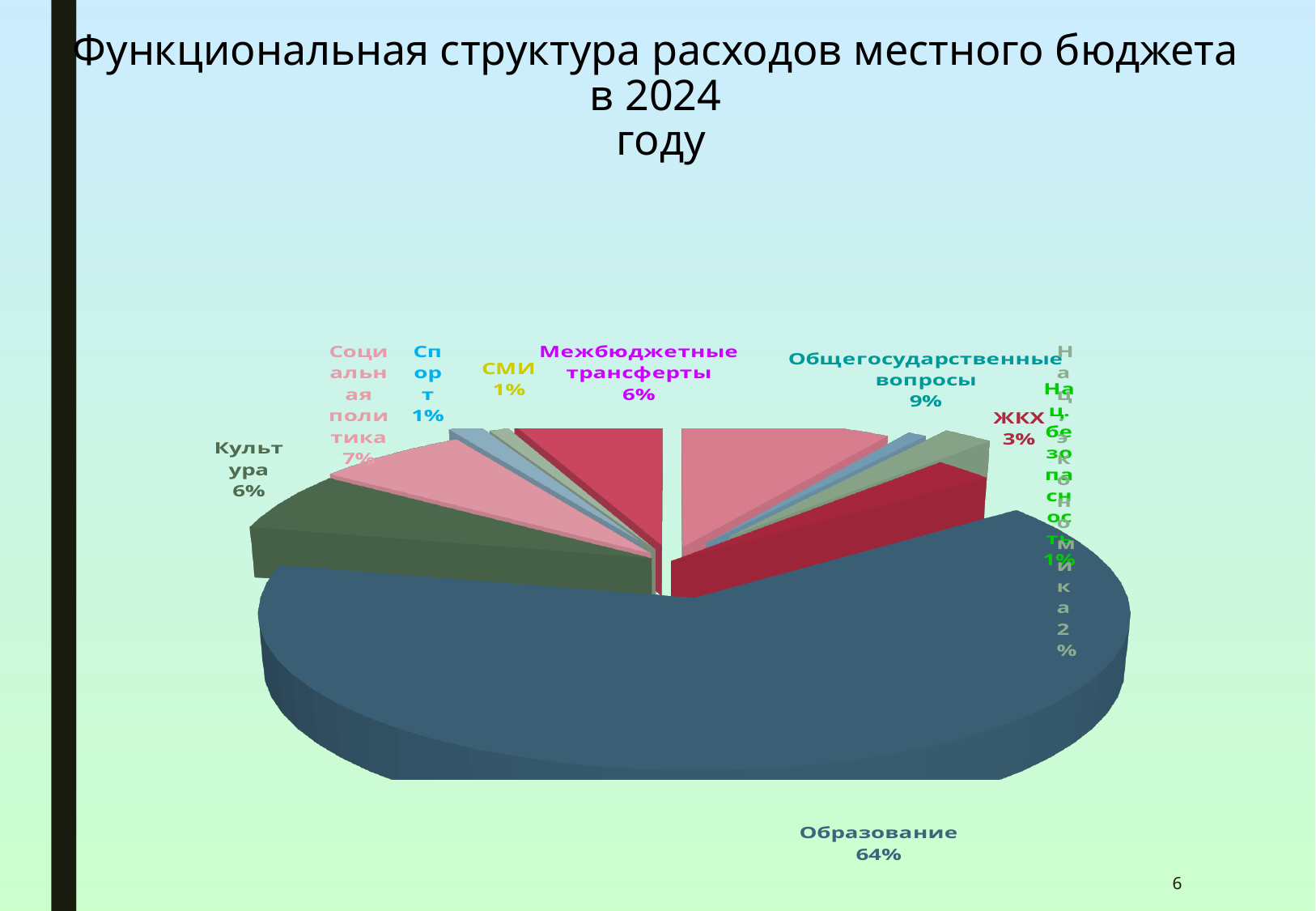
What percentage is shown for Общегосударственные вопросы? 9% Which category has the largest share of the pie? Образование What is the title of the slide? Функциональная структура расходов местного бюджета в 2024 году What is the difference in percentage points between Образование and Общегосударственные вопросы? 55% Which is larger, the share for Социальная политика or the share for Культура? Социальная политика What percentage is shown for ЖКХ? 3% What percentage is shown for Социальная политика? 7% What percentage is shown for Межбюджетные трансферты? 6% What kind of chart is shown on the slide? Pie chart What percentage is shown for СМИ? 1% What percentage is shown for Культура? 6% What share of the pie does Образование account for? 64%